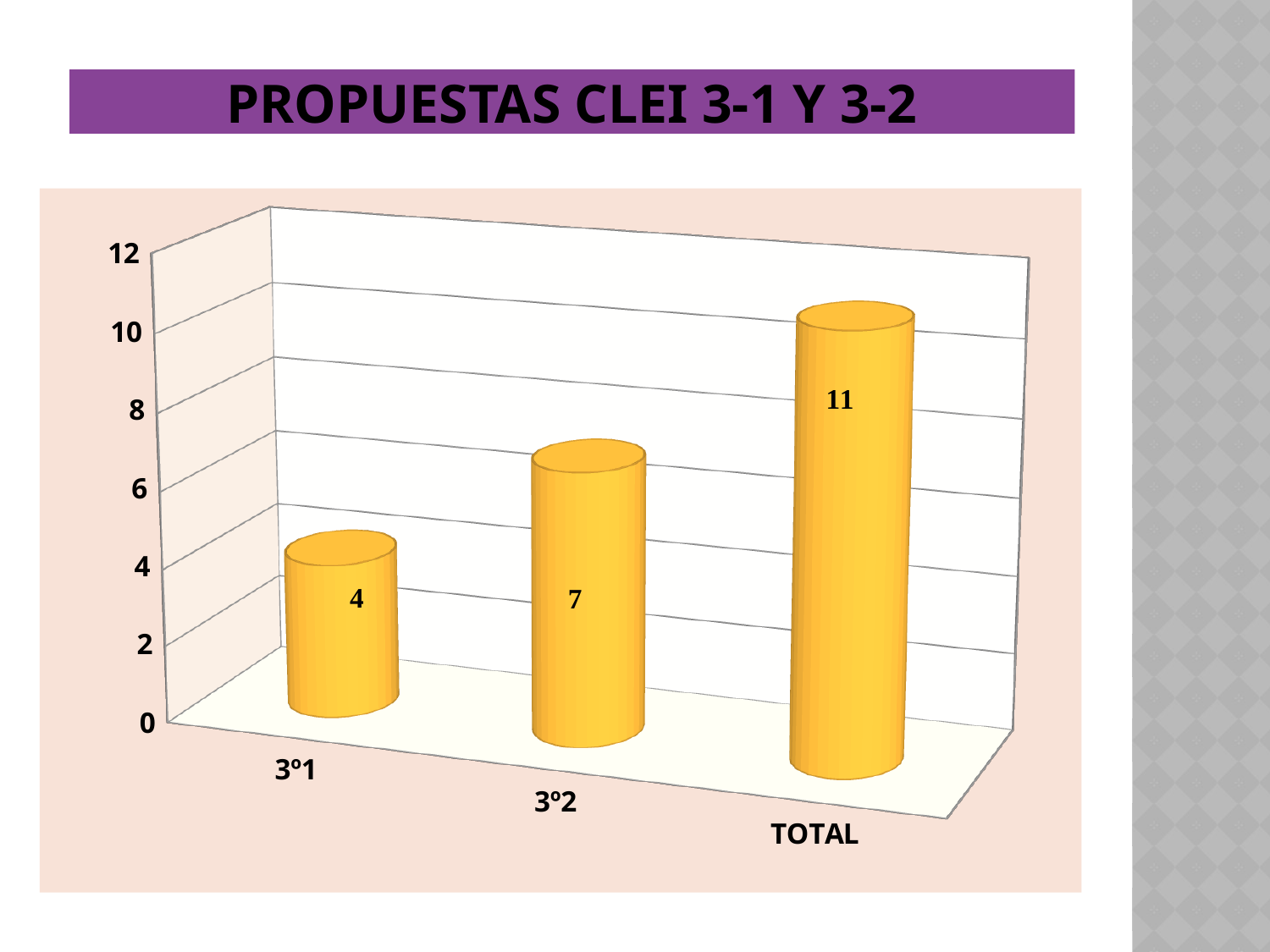
What is the title of the slide? PROPUESTAS CLEI 3-1 Y 3-2 How many categories are shown on the x axis? 3 Is the value for TOTAL greater or less than 10? greater What is the value for 3º2? 7 What is the difference between the values for 3º2 and 3º1? 3 Which is larger, the value for 3º1 or the value for 3º2? 3º2 Which category has the lowest value? 3º1 What is the value for TOTAL? 11 Which category has the highest value? TOTAL Do the values rise or fall from left to right along the x axis? rise What is the value for 3º1? 4 What kind of chart is shown on the slide? bar chart